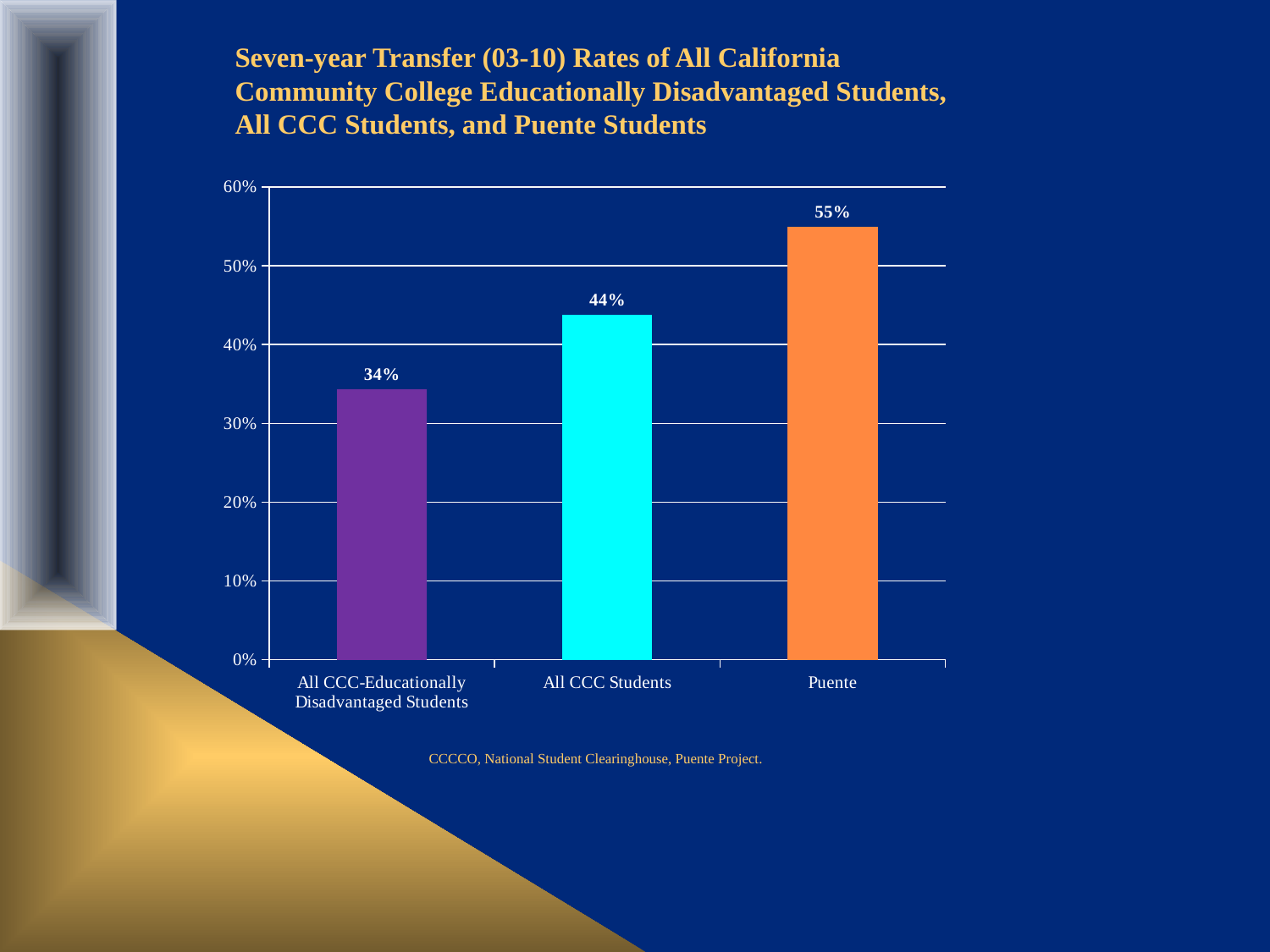
What is the difference in transfer rate between Puente and All CCC Students? 11% Which has a higher transfer rate, Puente or All CCC Students? Puente What is the seven-year transfer rate for All CCC Students? 44% How many student groups are shown in the chart? 3 Is the transfer rate for All CCC-Educationally Disadvantaged Students greater or less than 40%? less What colour is the bar for Puente? orange Which group has the highest transfer rate? Puente Which group has the lowest transfer rate? All CCC-Educationally Disadvantaged Students What is the seven-year transfer rate for All CCC-Educationally Disadvantaged Students? 34% What is the seven-year transfer rate for Puente students? 55% What kind of chart is shown on the slide? bar chart What is the difference in transfer rate between All CCC Students and All CCC-Educationally Disadvantaged Students? 10%